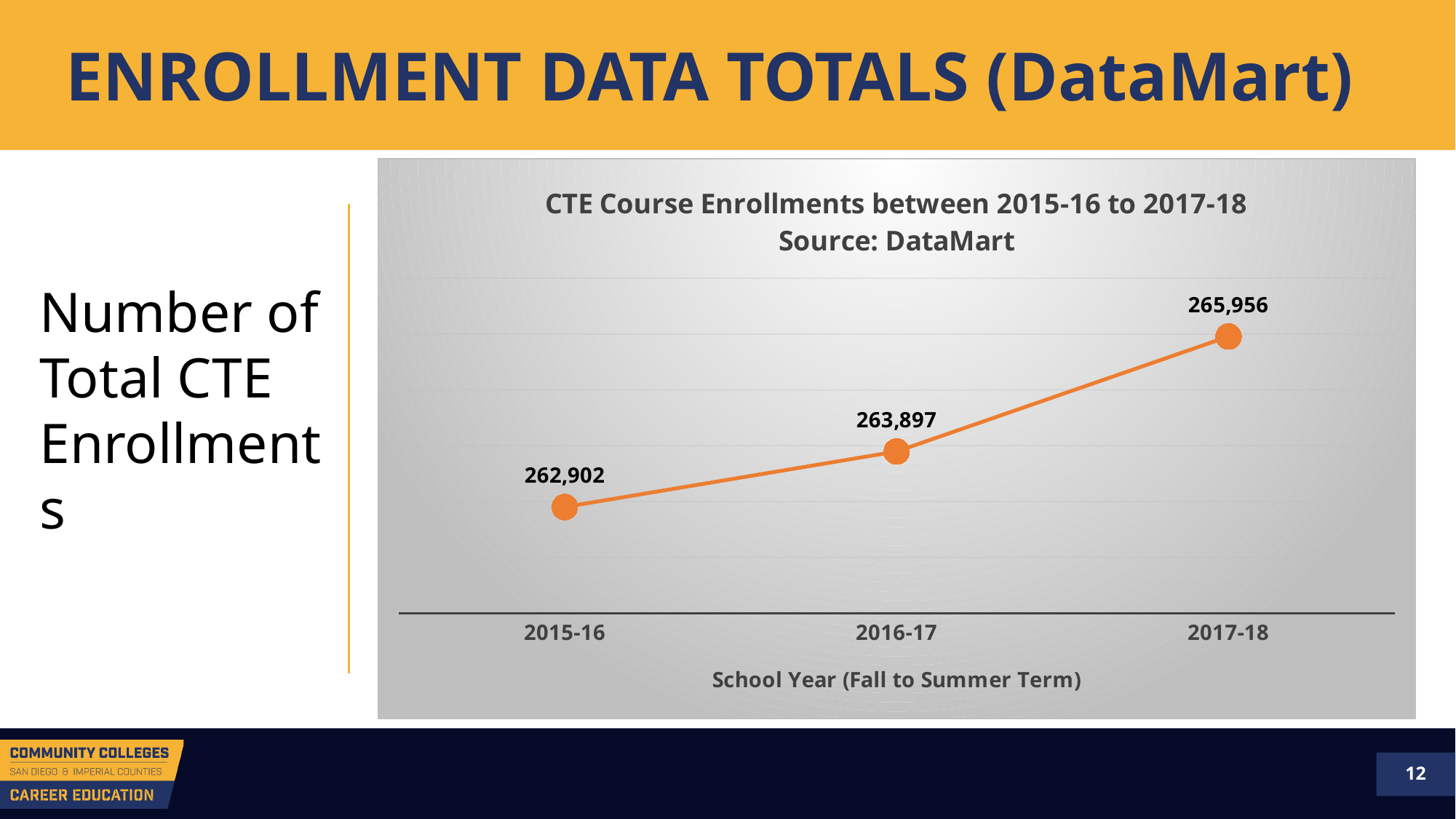
Which school year has the lowest CTE course enrollment? 2015-16 What kind of chart is shown on the slide? Line chart Do CTE course enrollments rise or fall from 2015-16 to 2017-18? Rise What is the label of the x axis on the chart? School Year (Fall to Summer Term) What is the difference in CTE course enrollments between 2017-18 and 2015-16? 3,054 Which school year has the highest CTE course enrollment? 2017-18 What is the difference in CTE course enrollments between 2016-17 and 2015-16? 995 Which school year has more CTE course enrollments, 2016-17 or 2017-18? 2017-18 How many school years are plotted on the chart? 3 What is the CTE course enrollment value for 2016-17? 263,897 What is the CTE course enrollment value for 2017-18? 265,956 What is the CTE course enrollment value for 2015-16? 262,902